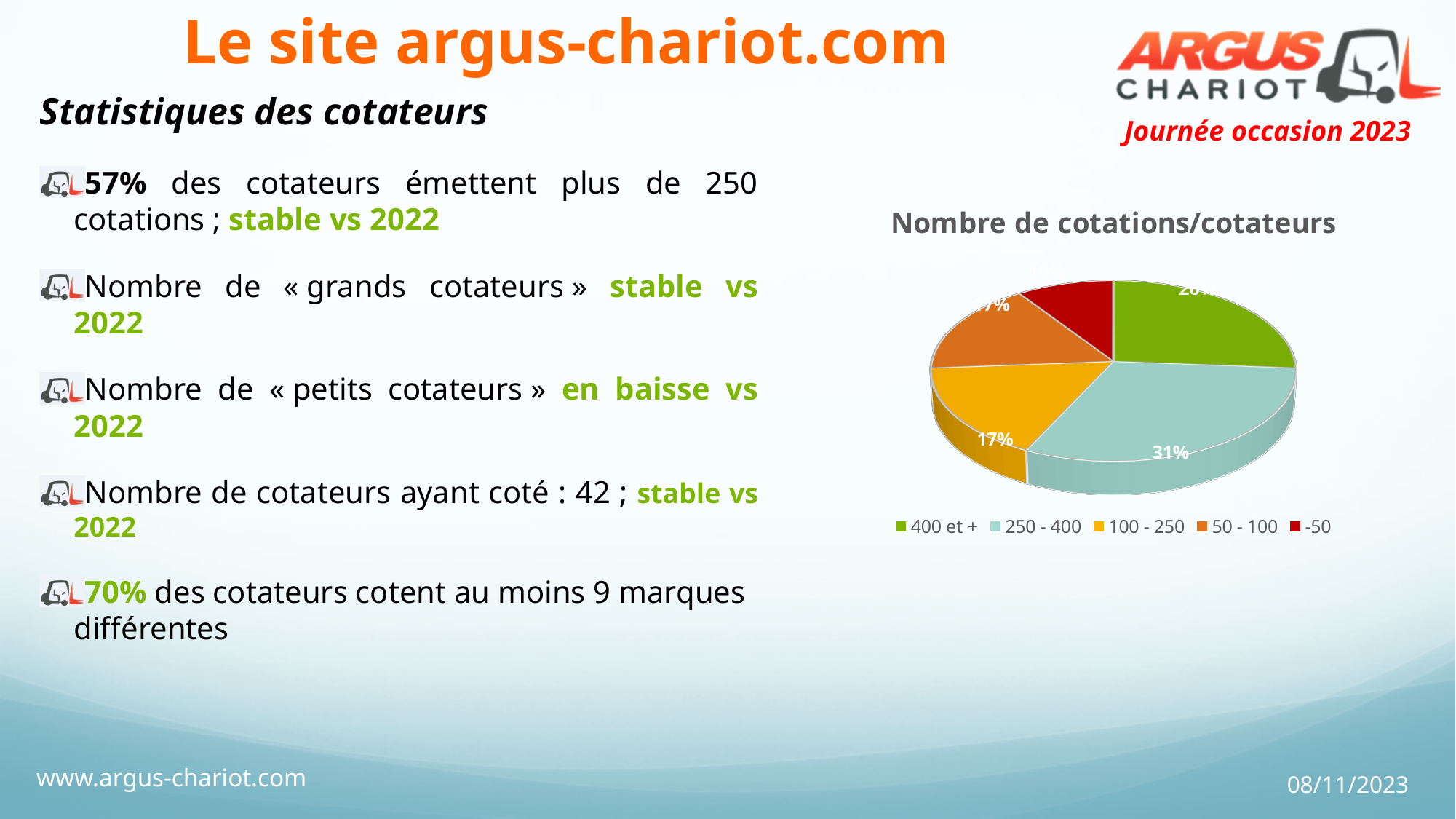
How many entries does the legend of the pie chart list? 5 Which category has the smallest slice of the pie? -50 What share of the pie does the '100 - 250' category represent? 17% Which slice is larger, '250 - 400' or '100 - 250'? 250 - 400 What kind of chart is shown on the slide? Pie chart Which slice is larger, '400 et +' or '100 - 250'? 400 et + What share of the pie does the '250 - 400' category represent? 31% What colour is the '-50' slice in the pie chart? Red How many slices does the pie chart have? 5 Which category has the largest slice of the pie? 250 - 400 What is the title of the pie chart? Nombre de cotations/cotateurs What is the difference in percentage points between the '250 - 400' slice and the '100 - 250' slice? 14